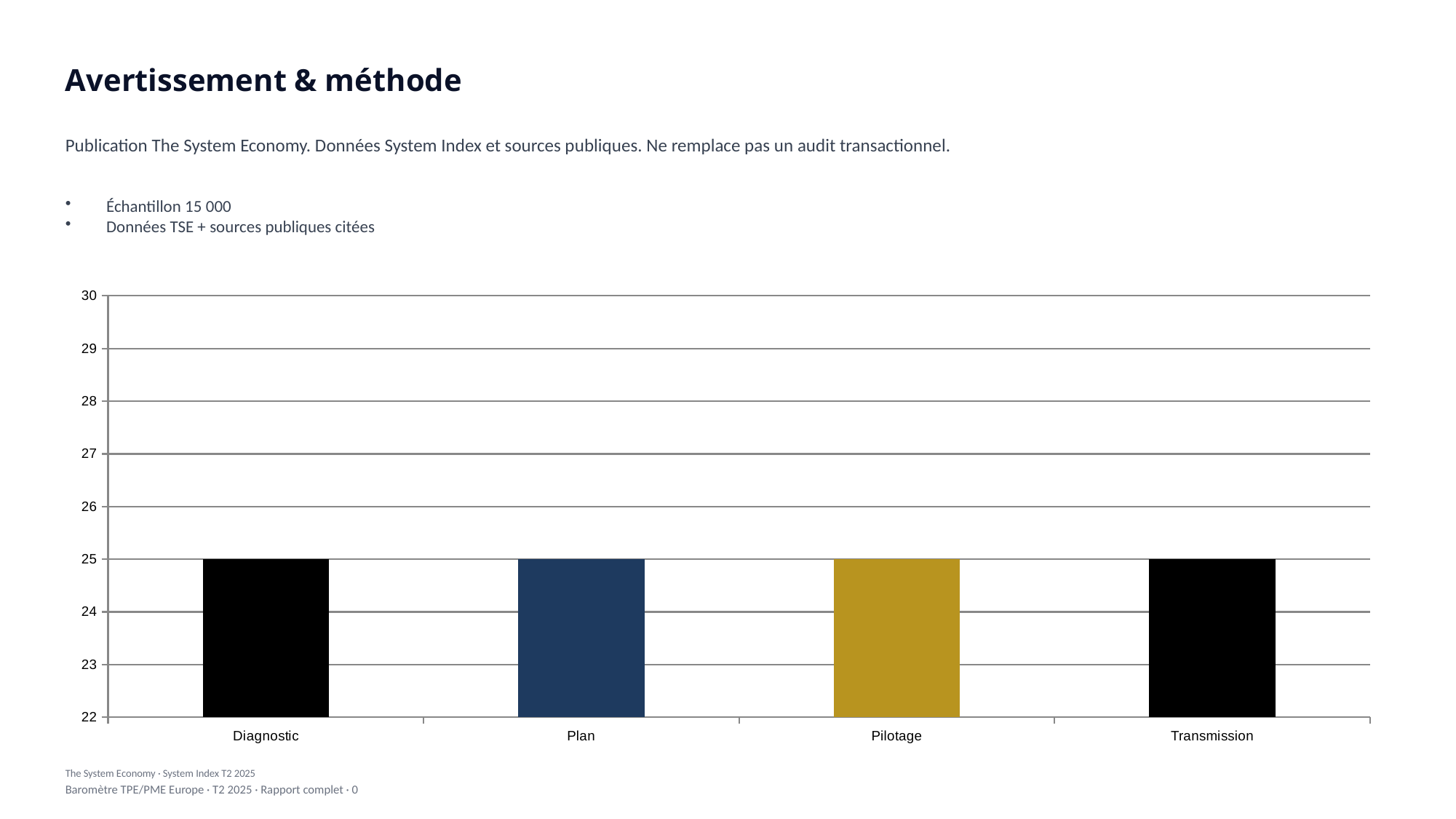
What colour is the bar for Pilotage? Gold Is the value for Plan greater or less than 24? greater What is the value for Diagnostic? 25 Is the value for Transmission greater or less than 26? less Is the value for Diagnostic greater or less than 28? less What is the value for Plan? 25 What kind of chart is shown on the slide? Bar chart What is the value for Transmission? 25 Do the values rise, fall or stay flat from Diagnostic to Transmission? Stay flat How many categories are shown on the x axis? 4 What is the difference between the values for Diagnostic and Pilotage? 0 What is the value for Pilotage? 25